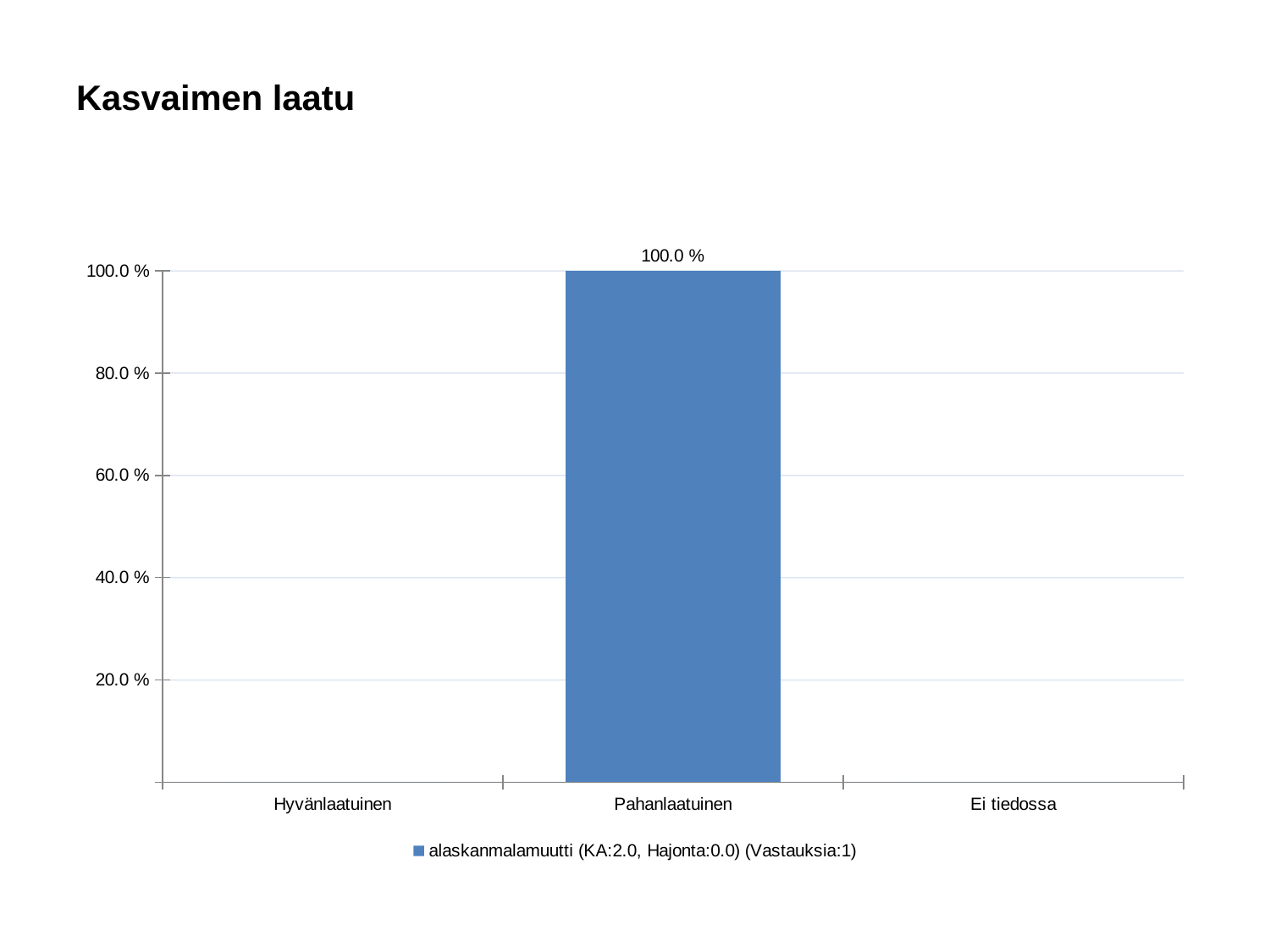
What is the legend entry for the series? alaskanmalamuutti (KA:2.0, Hajonta:0.0) (Vastauksia:1) What kind of chart is shown? bar chart What is the value for Pahanlaatuinen? 100.0 % What is the highest value shown on the y axis? 100.0 % Which category has the highest value? Pahanlaatuinen How many categories are shown on the x axis? 3 What is the title of the chart? Kasvaimen laatu Is the value for Pahanlaatuinen greater or less than 80.0 %? greater Which is larger, the value for Pahanlaatuinen or the value for Hyvänlaatuinen? Pahanlaatuinen Does the Hyvänlaatuinen category show a visible bar? No How many series does the legend list? 1